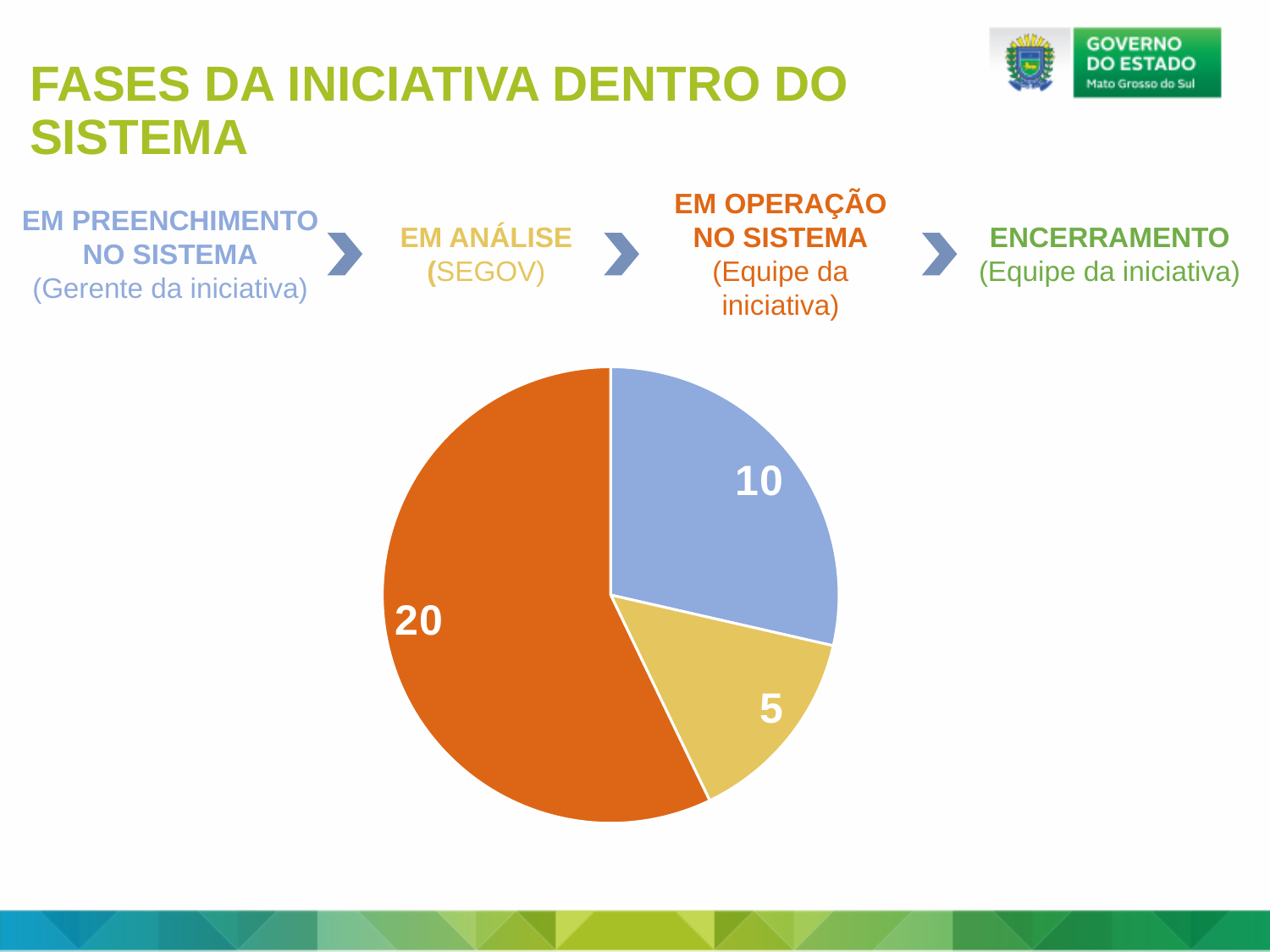
What is the value of the orange slice of the pie chart? 20 What kind of chart is shown on the slide? pie chart What is the value of the blue slice of the pie chart? 10 How many slices does the pie chart have? 3 What share of the pie chart does the orange slice (20) represent? 57.1% Which is larger in the pie chart, the blue slice or the yellow slice? the blue slice Which slice of the pie chart has the largest value? the orange slice (20) Which phase in the flow above the chart matches the colour of the largest pie slice? EM OPERAÇÃO NO SISTEMA Which slice of the pie chart has the smallest value? the yellow slice (5) What is the value of the yellow slice of the pie chart? 5 What is the difference between the orange slice and the blue slice in the pie chart? 10 What is the total of all the slices in the pie chart? 35